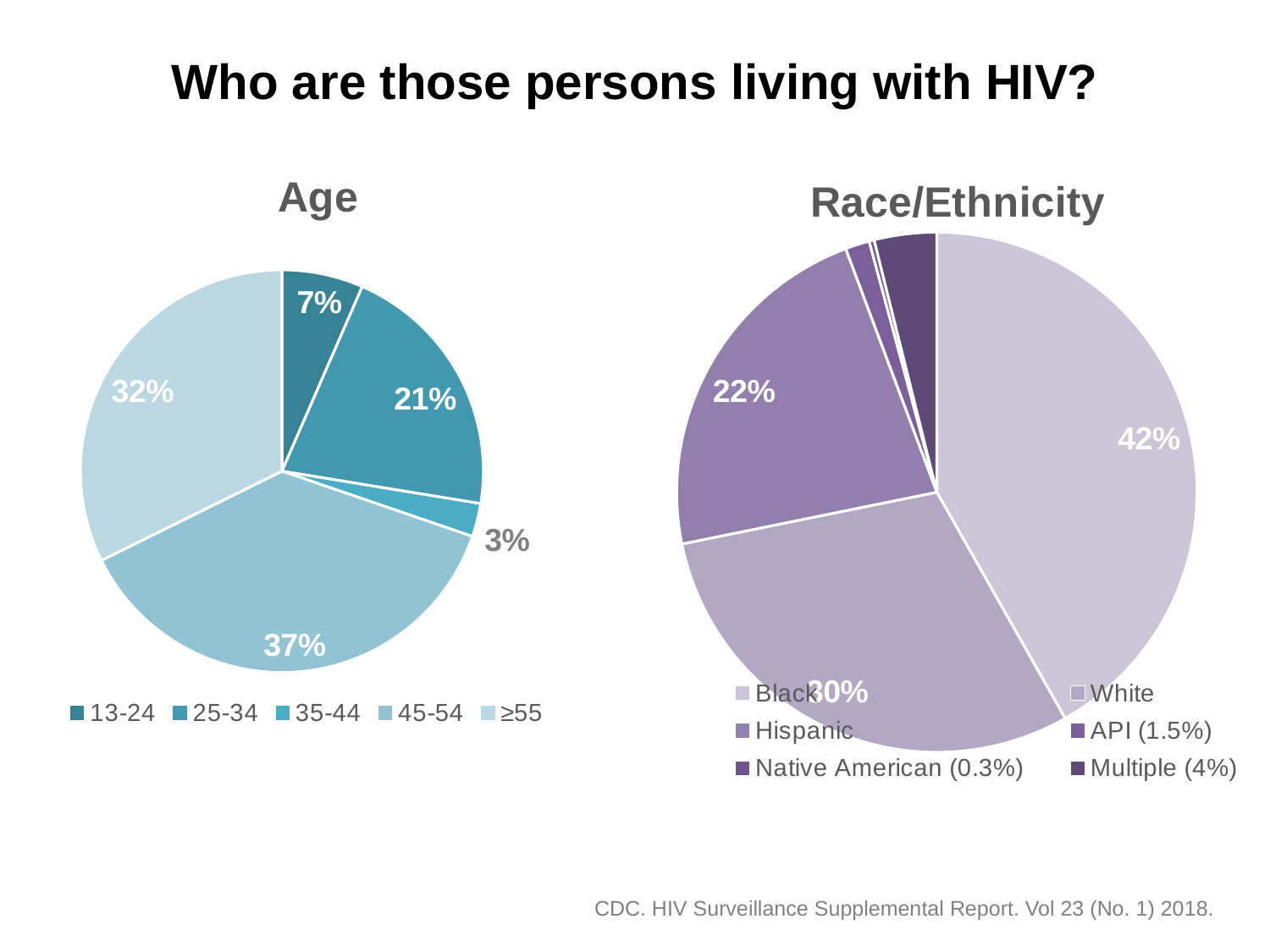
In the Race/Ethnicity pie chart, what percentage is given for Native American in the legend? 0.3% In the Age pie chart, which age group has the smallest share? 35-44 What type of chart is used for the Age data? Pie chart In the Age pie chart, how many age groups does the legend list? 5 In the Age pie chart, what percentage is shown for the 45-54 age group? 37% In the Age pie chart, what percentage is shown for the 13-24 age group? 7% In the Race/Ethnicity pie chart, which group has the largest share? Black In the Age pie chart, what is the difference between the shares for 45-54 and ≥55? 5% In the Race/Ethnicity pie chart, what percentage is shown for Black? 42% In the Race/Ethnicity pie chart, which is larger, the share for White or the share for Hispanic? White In the Race/Ethnicity pie chart, what percentage is shown for Hispanic? 22% In the Age pie chart, which age group has the largest share? 45-54